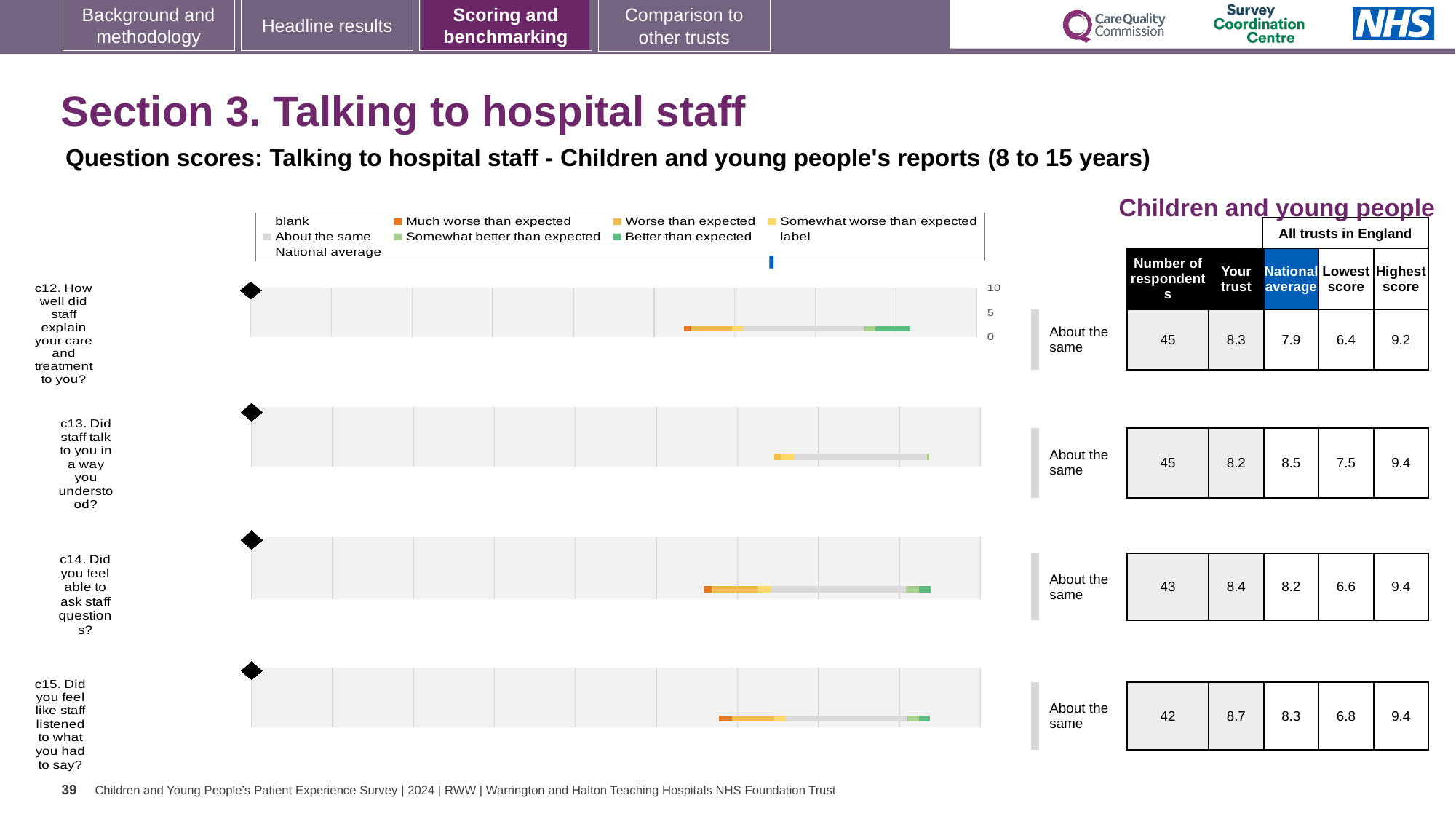
For question c15 (Did you feel like staff listened to what you had to say?), what is the lowest score among all trusts in England? 6.8 Which question has the lowest 'Your trust' score? c13 For question c13, which is larger: the 'Your trust' score or the national average? National average For question c12, what is the difference between the 'Your trust' score and the national average? 0.4 For question c14 (Did you feel able to ask staff questions?), how many respondents are there? 43 What benchmark label is shown for question c14? About the same For question c12 (How well did staff explain your care and treatment to you?), what is the 'Your trust' score? 8.3 How many question charts are shown on the slide (c12 to c15)? 4 What kind of chart is used for each question (c12 to c15) on the slide? bar chart In the legend, what colour represents 'Much worse than expected'? Orange For question c13 (Did staff talk to you in a way you understood?), what is the national average score? 8.5 Which question has the highest 'Your trust' score? c15